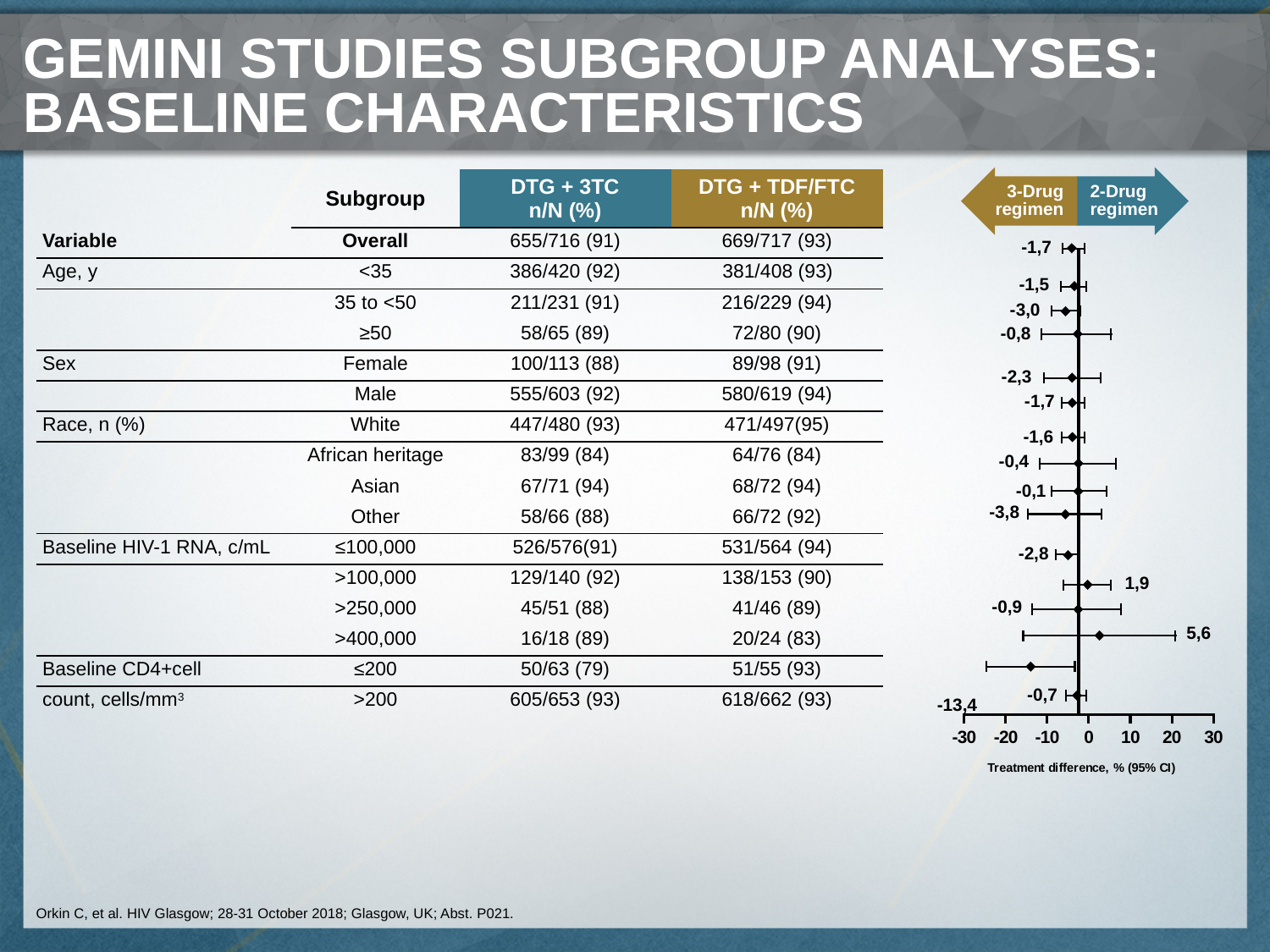
Which labelled treatment difference in the forest plot is the highest? 5,6 What is the x-axis title of the forest plot? Treatment difference, % (95% CI) In the forest plot, is the treatment difference for the >400,000 c/mL subgroup greater or less than 0? greater What is the difference between the two positive treatment differences in the forest plot, 5,6 and 1,9? 3,7 What are the minimum and maximum tick values on the x-axis of the forest plot? -30 and 30 In the forest plot, what is the treatment difference shown for the >100,000 c/mL baseline HIV-1 RNA subgroup? 1,9 What kind of chart is shown on the right of the slide? Forest plot (point estimates with 95% CI error bars) In the forest plot, what is the treatment difference shown for the Female subgroup? -2,3 In the forest plot, which is larger: the treatment difference for the >100,000 subgroup (1,9) or the >400,000 subgroup (5,6)? 5,6 (>400,000) Which labelled treatment difference in the forest plot is the lowest? -13,4 In the forest plot, what is the treatment difference shown for the Overall (top) row? -1,7 How many point estimates are plotted in the forest plot? 16